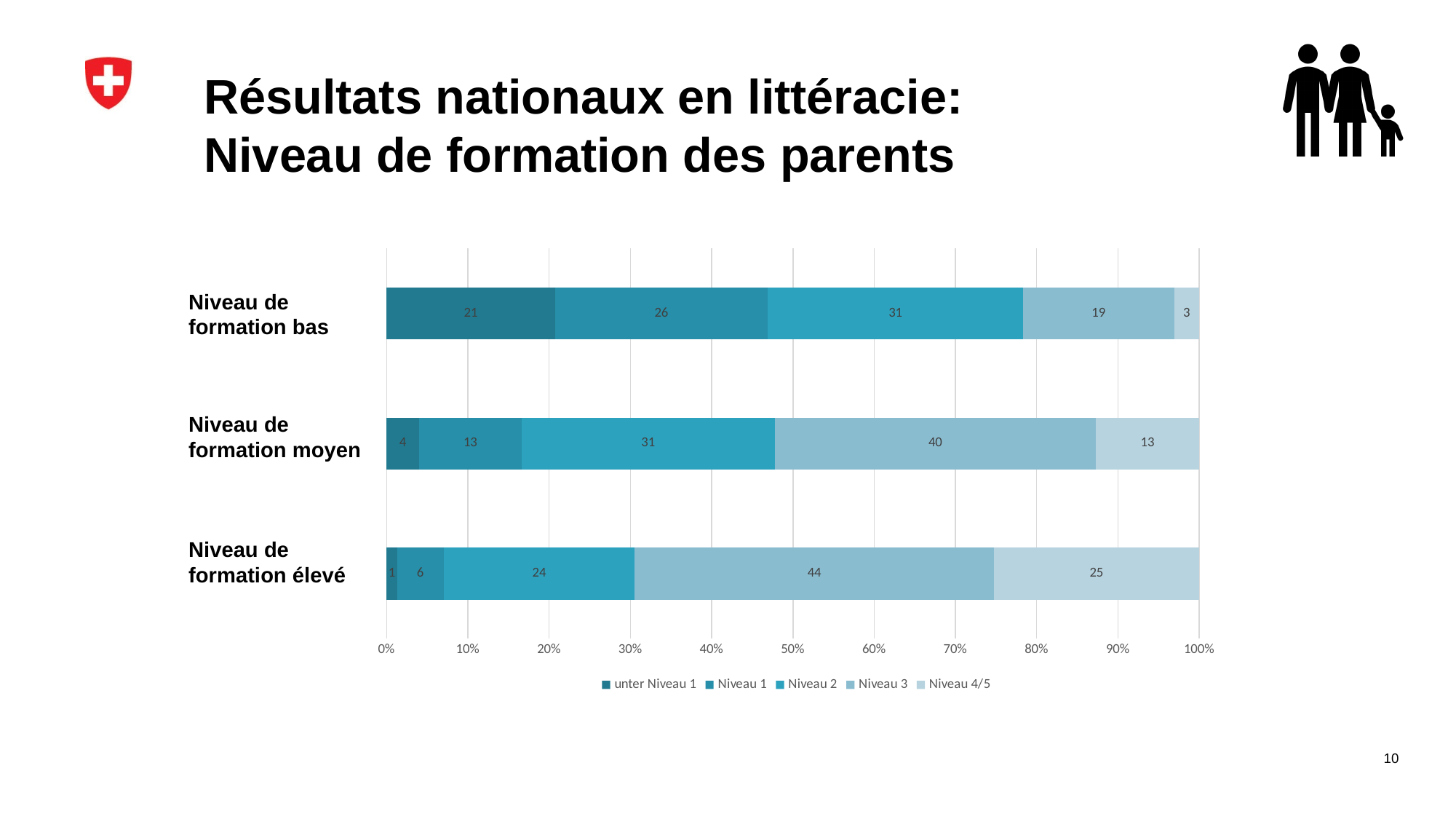
What is the value of Niveau 3 for 'Niveau de formation élevé'? 44 What is the difference between the Niveau 3 values for 'Niveau de formation moyen' and 'Niveau de formation bas'? 21 What kind of chart is shown on the slide? Stacked bar chart How many categories (parent education levels) are shown on the chart? 3 What is the value of Niveau 2 for 'Niveau de formation bas'? 31 Which category has the highest value for Niveau 4/5? Niveau de formation élevé How many series does the legend list? 5 Which is larger: the Niveau 1 value for 'Niveau de formation bas' or for 'Niveau de formation moyen'? Niveau de formation bas What is the total of the stacked bar for 'Niveau de formation élevé'? 100 What is the value of Niveau 4/5 for 'Niveau de formation moyen'? 13 Which category has the lowest value for 'unter Niveau 1'? Niveau de formation élevé What is the value of 'unter Niveau 1' for 'Niveau de formation bas'? 21